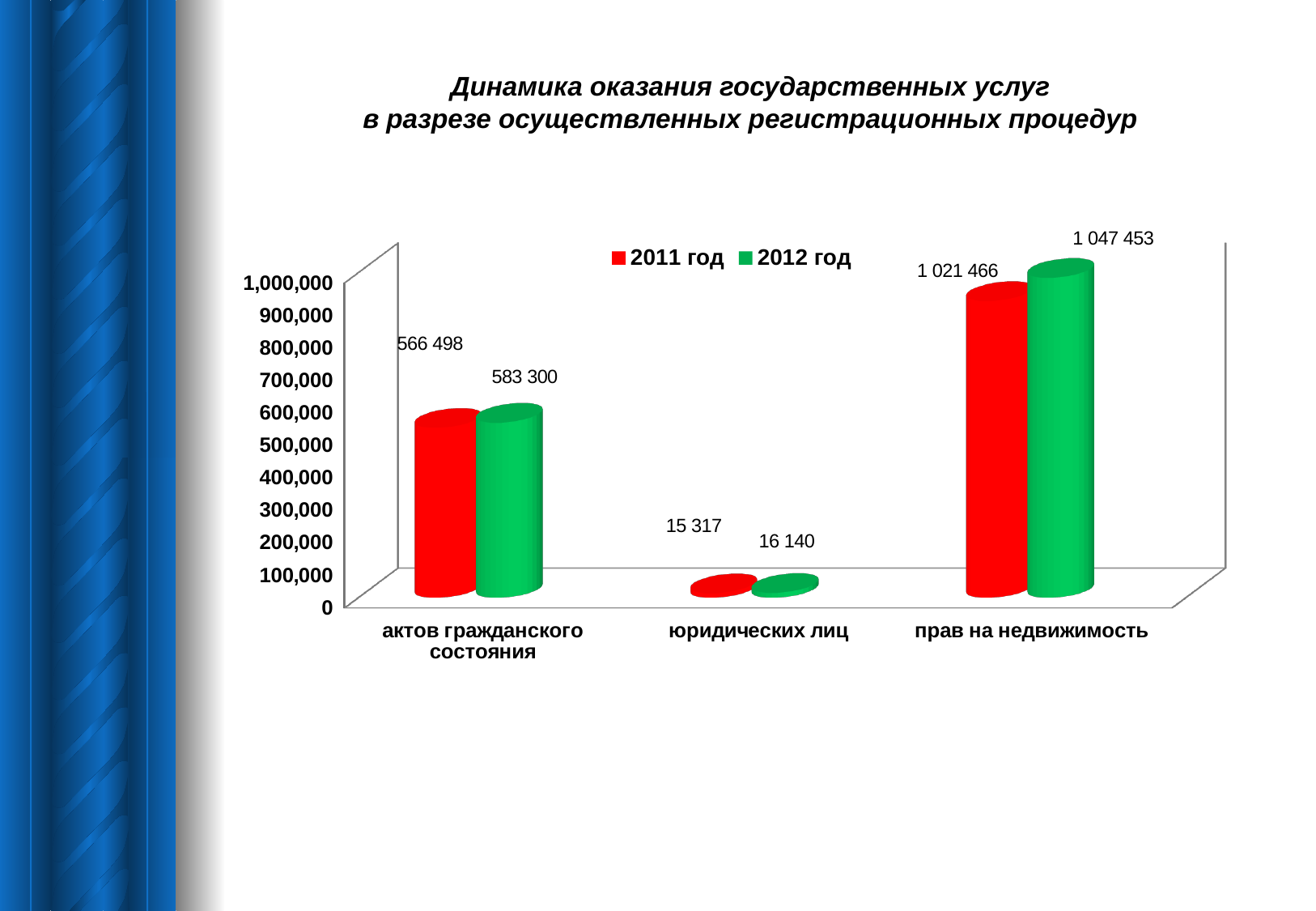
What is the difference between the 2012 год and 2011 год values for актов гражданского состояния? 16 802 Which is larger for юридических лиц: the 2011 год value or the 2012 год value? 2012 год What is the value for 2012 год in the category актов гражданского состояния? 583 300 Which category has the highest value for 2012 год? прав на недвижимость How many categories are shown on the x axis? 3 What is the value for 2011 год in the category юридических лиц? 15 317 What is the value for 2012 год in the category прав на недвижимость? 1 047 453 How many series does the legend list? 2 What kind of chart is shown on the slide? bar chart What is the value for 2011 год in the category актов гражданского состояния? 566 498 Which category has the lowest value for 2011 год? юридических лиц What is the difference between the 2012 год and 2011 год values for прав на недвижимость? 25 987